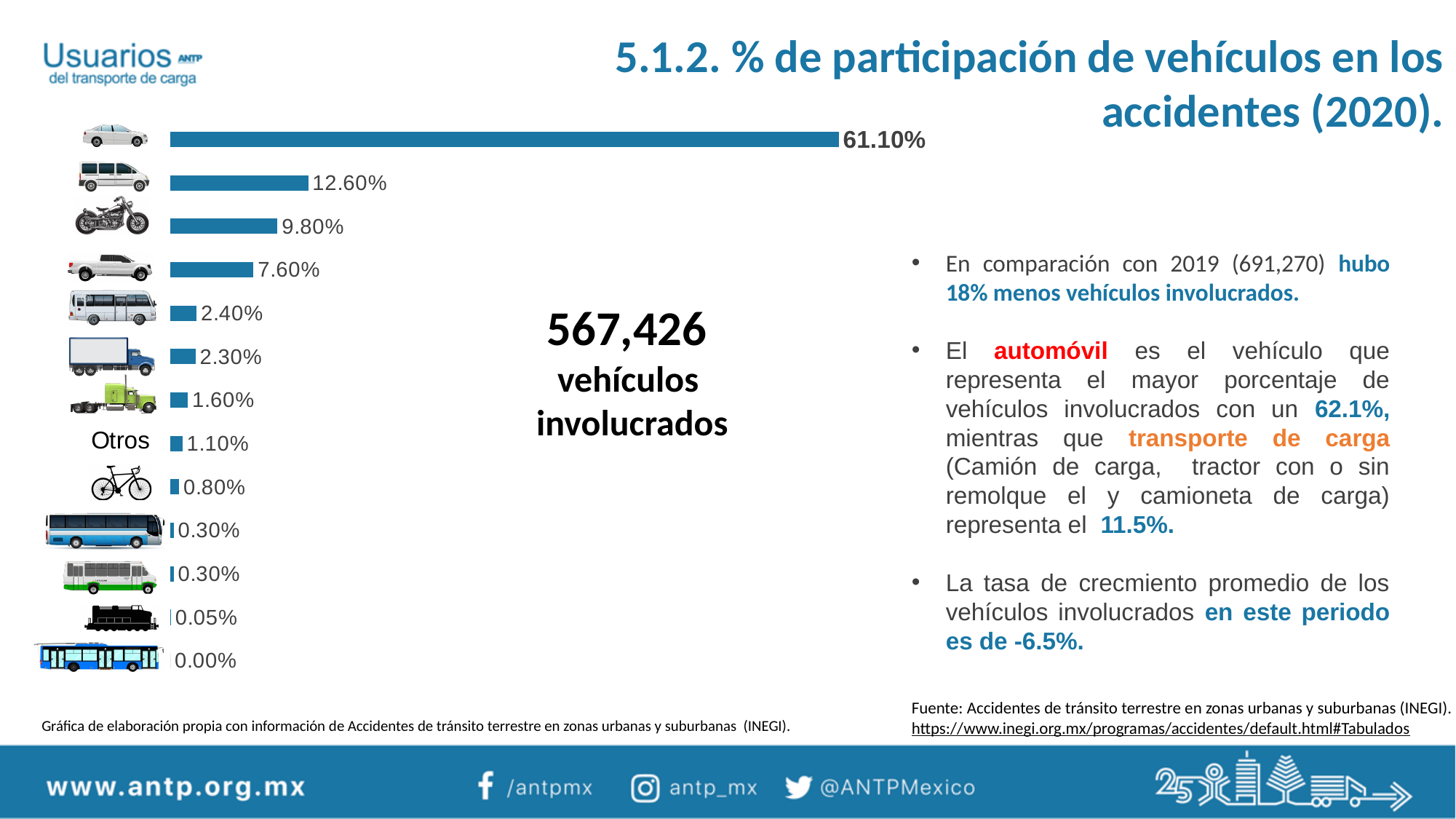
What is the lowest value shown in the chart? 0.00% What is the value of the bottom bar in the chart? 0.00% What is the value shown for the category labelled "Otros"? 1.10% Which is larger: the value for "Otros" or the value of the bar directly below it? Otros What is the difference between the value for "Otros" (1.10%) and the bar directly below it (0.80%)? 0.30% What kind of chart is shown on the left of the slide? bar chart Do the bar values increase or decrease going from the top of the chart to the bottom? decrease How many bars (categories) does the chart contain? 13 What is the value of the top (longest) bar in the chart? 61.10% What is the value of the second bar from the top? 12.60% What is the difference between the top bar (61.10%) and the second bar (12.60%)? 48.50% What total number of vehicles involved is printed in large text next to the chart? 567,426